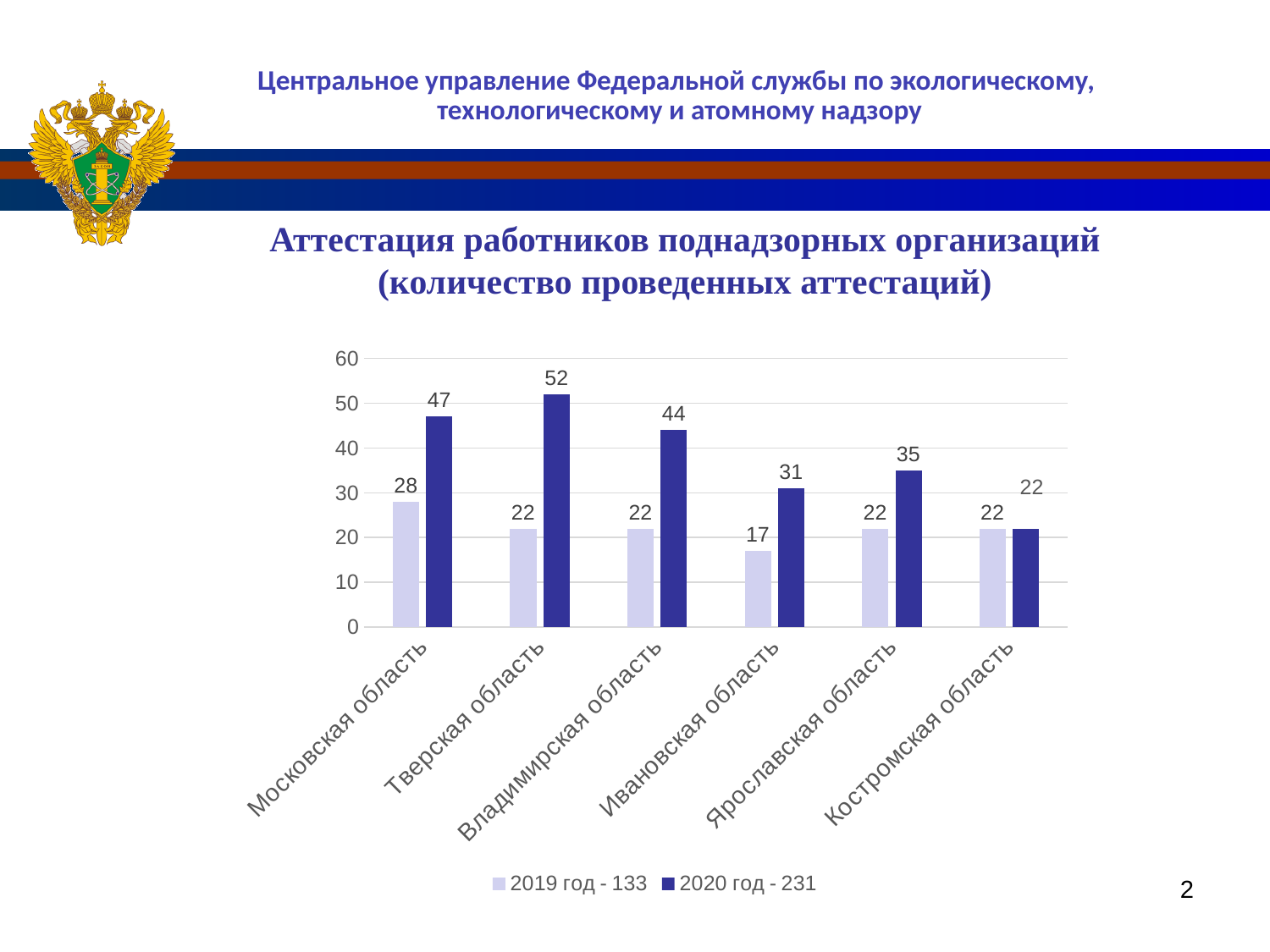
Which category has the highest value in the 2020 год series? Тверская область How many series does the legend list? 2 Which category has the lowest value in the 2019 год series? Ивановская область How many categories are shown on the x axis? 6 What is the value for Ивановская область in the 2019 год series? 17 What total is shown in the legend entry for the 2020 год series? 231 What is the value for Костромская область in the 2020 год series? 22 What is the difference between the 2020 год values for Московская область and Ярославская область? 12 What is the difference between the 2020 год and 2019 год values for Тверская область? 30 What is the value for Московская область in the 2020 год series? 47 What kind of chart is shown on the slide? bar chart Which is larger for Владимирская область: the 2019 год value or the 2020 год value? 2020 год